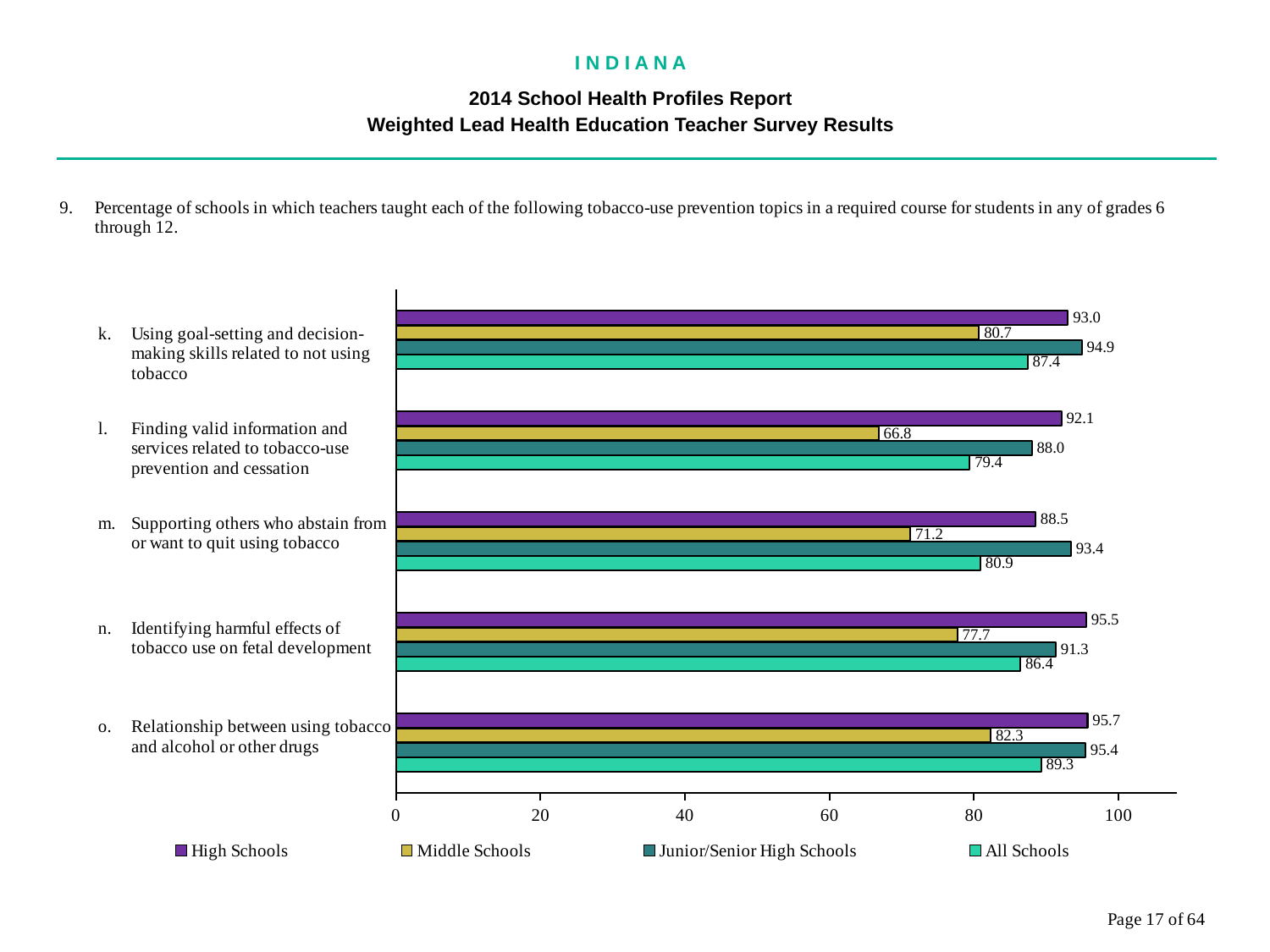
For topic n, identifying harmful effects of tobacco use on fetal development, which is larger: the High Schools value or the Junior/Senior High Schools value? High Schools What is the Junior/Senior High Schools value for topic m, supporting others who abstain from or want to quit using tobacco? 93.4 Is the Middle Schools value for topic l greater or less than 80? less How many series does the legend list? 4 Which series is listed first in the legend? High Schools Which topic has the highest High Schools value? o. Relationship between using tobacco and alcohol or other drugs Which topic has the lowest Middle Schools value? l. Finding valid information and services related to tobacco-use prevention and cessation How many tobacco-use prevention topics are shown in the chart? 5 What is the Middle Schools value for topic l, finding valid information and services related to tobacco-use prevention and cessation? 66.8 For topic k, how much higher is the High Schools value than the Middle Schools value? 12.3 What kind of chart is shown on the slide? bar chart What is the All Schools value for topic o, relationship between using tobacco and alcohol or other drugs? 89.3